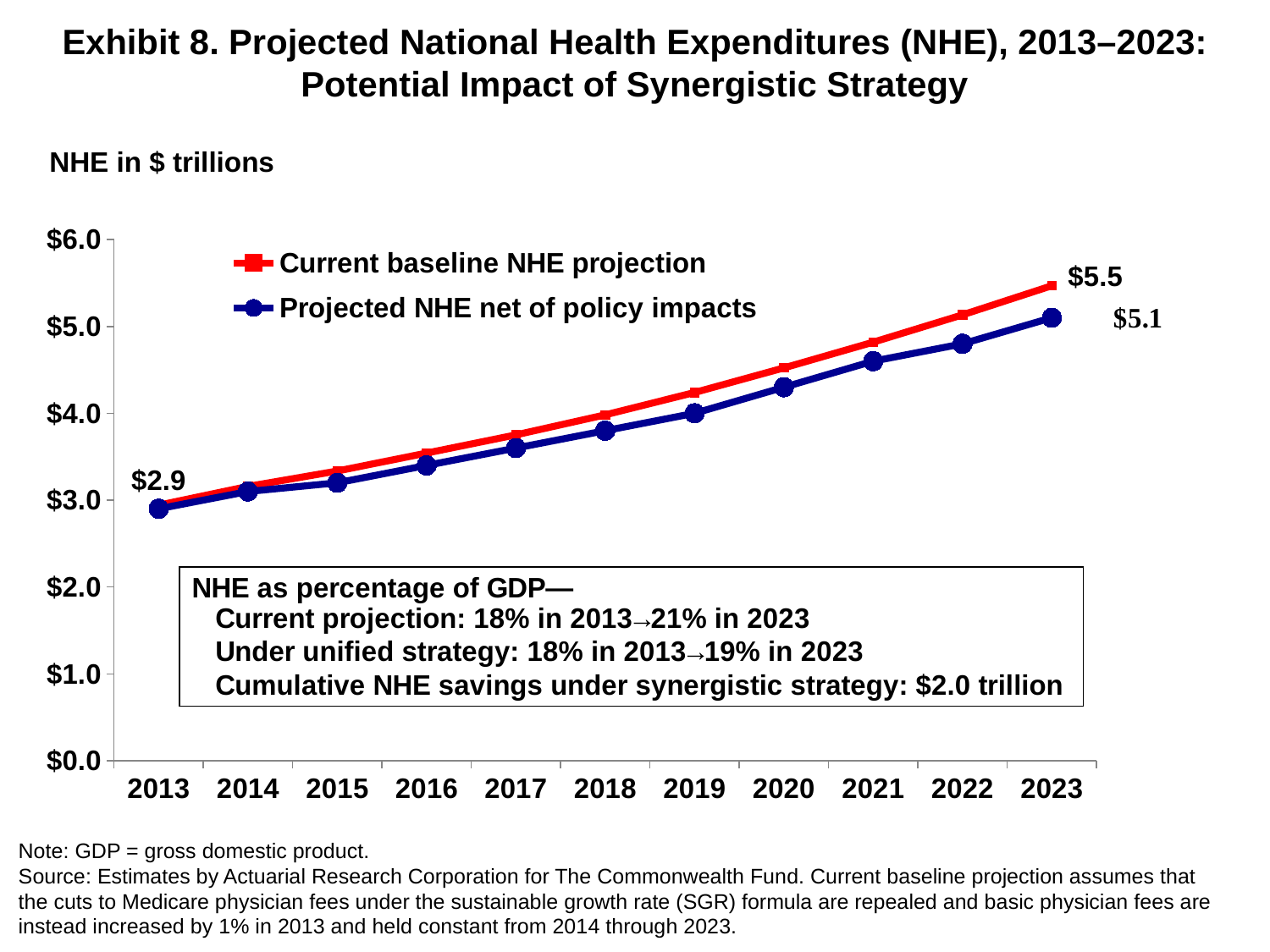
In 2023, which series has the higher value: the current baseline NHE projection or the projected NHE net of policy impacts? Current baseline NHE projection By how much does the current baseline NHE projection increase from 2013 to 2023? $2.6 Do the values of the current baseline NHE projection rise or fall from 2013 to 2023? Rise What kind of chart is shown on the slide? Line chart What is the projected NHE net of policy impacts in 2023? $5.1 What is the NHE value shown for 2013? $2.9 Is the current baseline NHE projection for 2020 greater or less than $4.0? greater What is the value of the current baseline NHE projection in 2023? $5.5 What is the difference between the current baseline NHE projection and the projected NHE net of policy impacts in 2023? $0.4 How many years are shown on the x axis? 11 How many series does the legend list? 2 Is the projected NHE net of policy impacts for 2016 greater or less than $3.0? greater